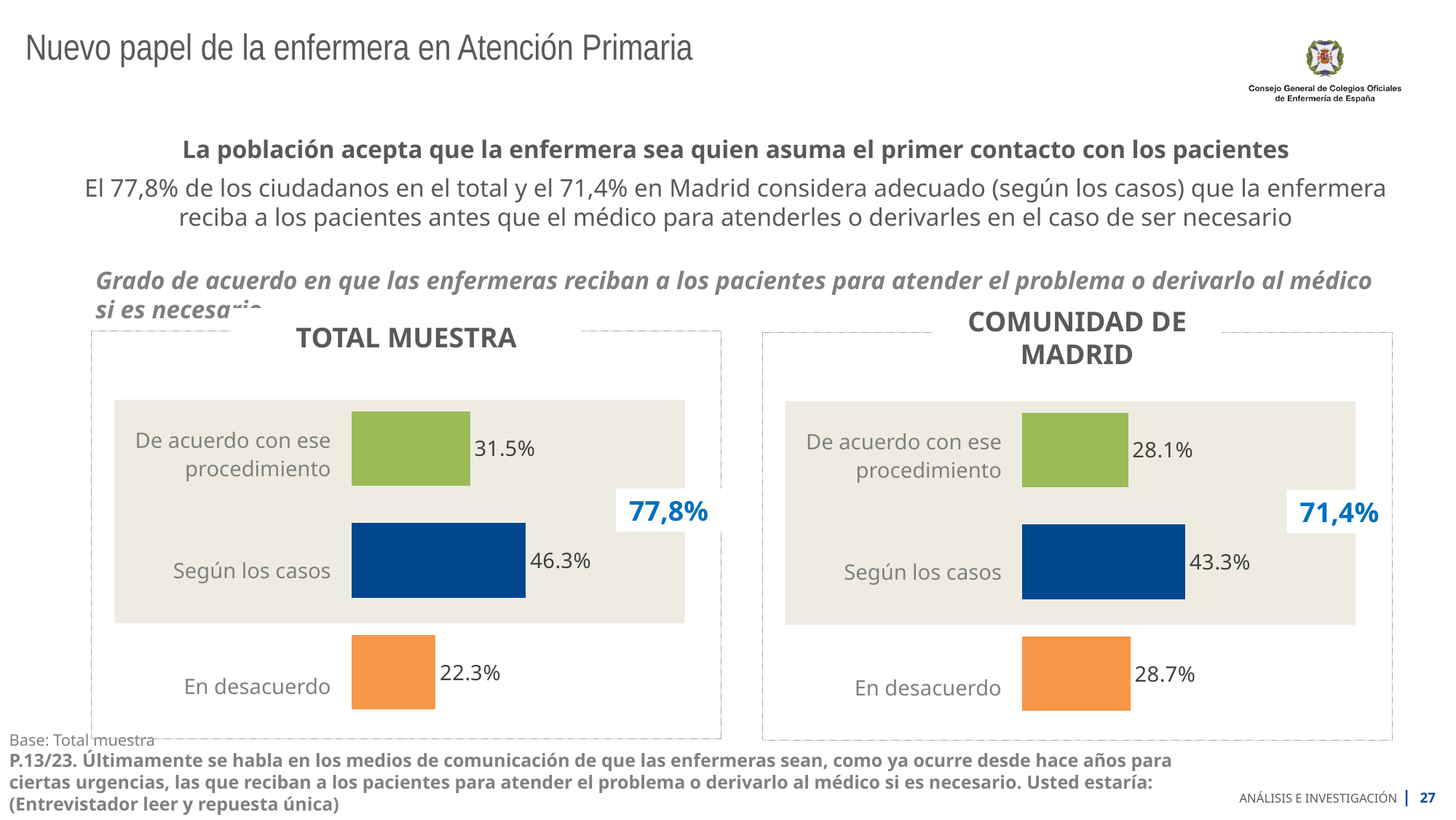
In the TOTAL MUESTRA chart, what is the difference between "Según los casos" and "En desacuerdo"? 24 percentage points Is the value for "En desacuerdo" higher in the TOTAL MUESTRA chart or in the COMUNIDAD DE MADRID chart? COMUNIDAD DE MADRID In the TOTAL MUESTRA chart, which category has the lowest value? En desacuerdo In the COMUNIDAD DE MADRID chart, what is the difference between "Según los casos" and "De acuerdo con ese procedimiento"? 15.2 percentage points What type of chart is used for COMUNIDAD DE MADRID? Bar chart What combined percentage is highlighted in blue next to the TOTAL MUESTRA chart? 77,8% In the TOTAL MUESTRA chart, what is the value for "Según los casos"? 46.3% In the COMUNIDAD DE MADRID chart, what is the value for "En desacuerdo"? 28.7% How many categories does the TOTAL MUESTRA chart show? 3 In the TOTAL MUESTRA chart, what is the value for "De acuerdo con ese procedimiento"? 31.5% In the COMUNIDAD DE MADRID chart, which is larger: "De acuerdo con ese procedimiento" or "En desacuerdo"? En desacuerdo In the COMUNIDAD DE MADRID chart, which category has the highest value? Según los casos